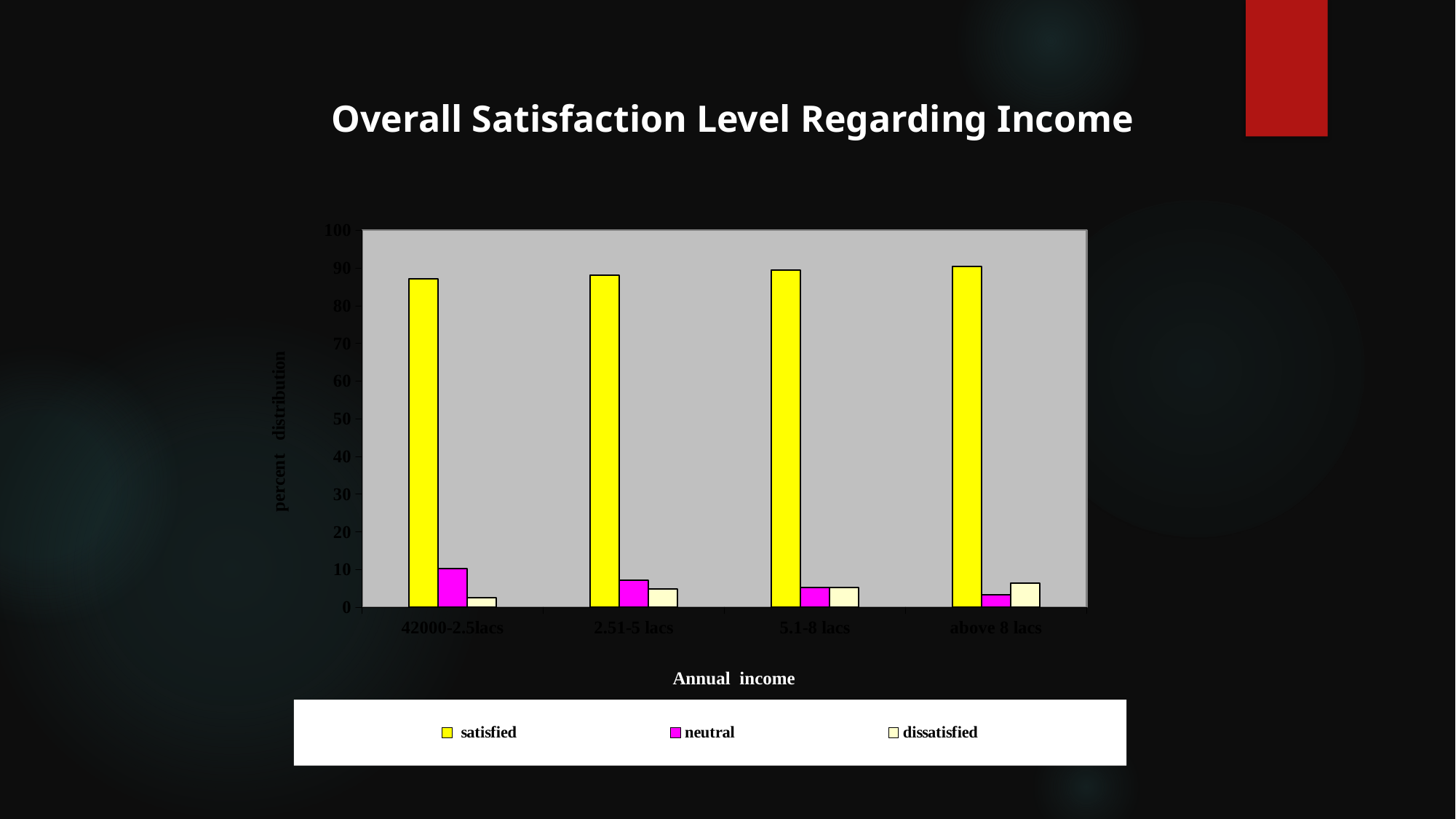
Do the neutral values rise or fall across the income categories from left to right? fall Which annual income category has the highest neutral value? 42000-2.5lacs What is the label of the y axis? percent distribution How many annual income categories are shown on the x axis? 4 Which is larger in the 42000-2.5lacs category, neutral or dissatisfied? neutral What is the title of the chart? Overall Satisfaction Level Regarding Income What kind of chart is shown on the slide? bar chart Is the value for satisfied in the 42000-2.5lacs category greater or less than 80? greater Is the value for neutral in the 42000-2.5lacs category greater or less than 20? less How many series does the legend list? 3 Which is larger in the above 8 lacs category, neutral or dissatisfied? dissatisfied Is the value for dissatisfied in the above 8 lacs category greater or less than 10? less